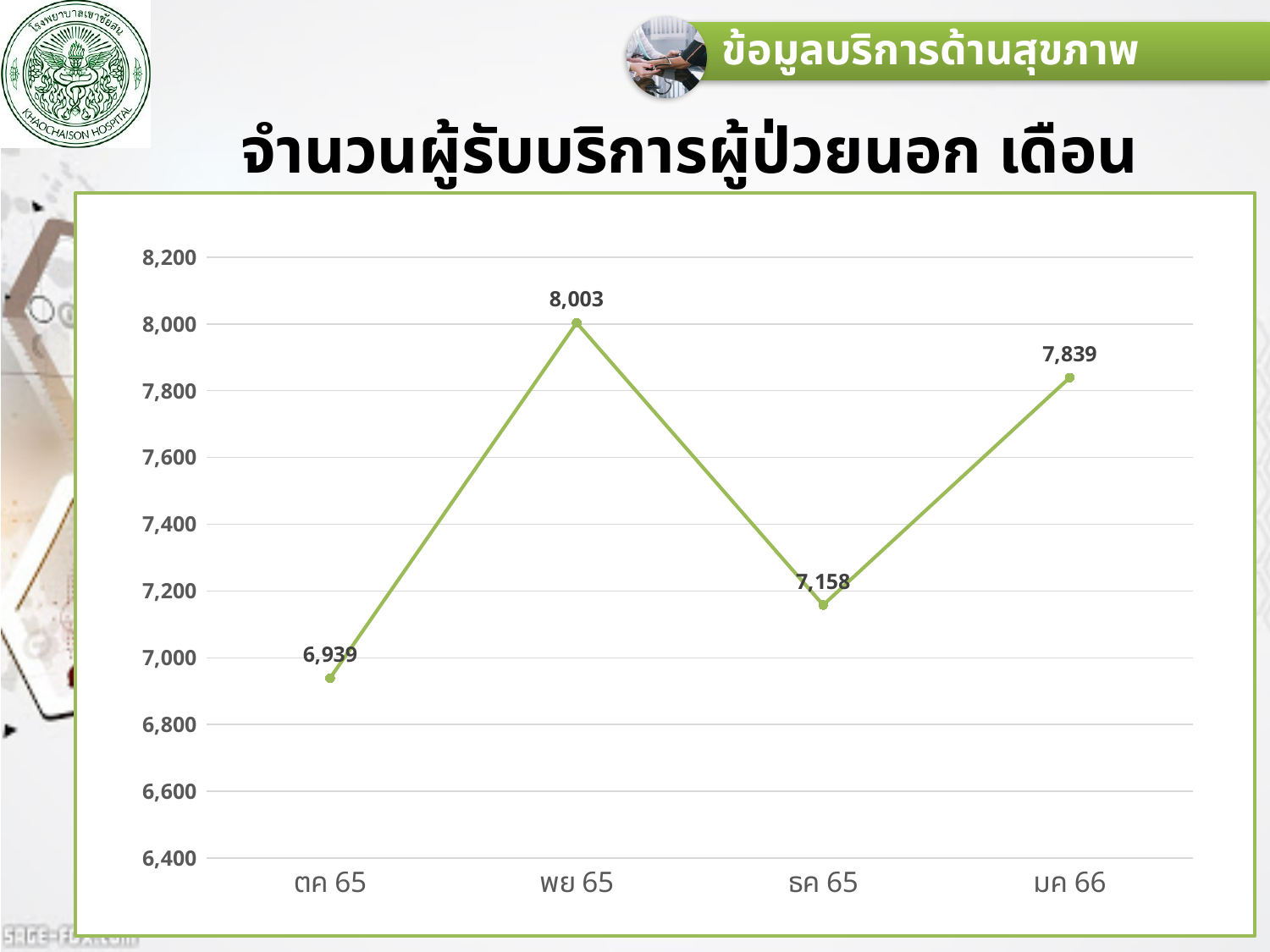
Which month has the lowest value? ตค 65 Is the value for ตค 65 greater or less than 7,000? less Which month has the highest value? พย 65 What is the difference between the values for พย 65 and ตค 65? 1,064 What is the value for ตค 65? 6,939 How many data points are plotted on the chart? 4 What is the value for มค 66? 7,839 Which is larger, the value for ธค 65 or the value for มค 66? มค 66 What is the value for พย 65? 8,003 What is the difference between the values for มค 66 and ธค 65? 681 What kind of chart is shown on the slide? line chart What is the value for ธค 65? 7,158